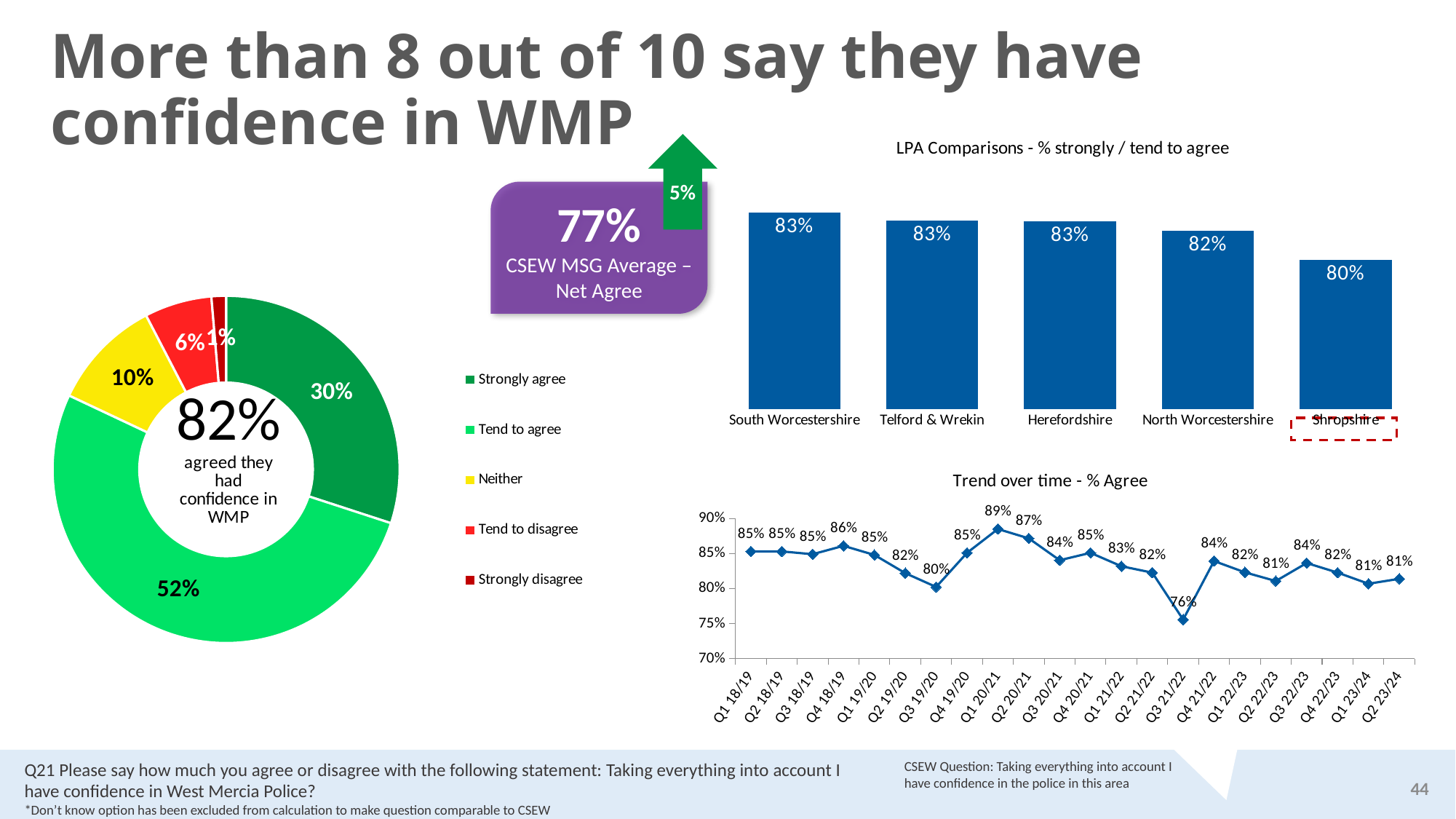
In the 'LPA Comparisons - % strongly / tend to agree' chart, which LPA has the lowest value? Shropshire In the donut chart on the left, what percentage of respondents said they 'Tend to agree'? 52% In the donut chart on the left, what is the difference between the 'Neither' share and the 'Tend to disagree' share? 4% In the 'LPA Comparisons - % strongly / tend to agree' chart, what is the value for Shropshire? 80% In the 'Trend over time - % Agree' chart, what is the value for Q3 21/22? 76% In the 'Trend over time - % Agree' chart, which quarter has the highest value? Q1 20/21 What kind of chart is the 'LPA Comparisons - % strongly / tend to agree' chart? Bar chart In the donut chart on the left, which response category has the smallest share? Strongly disagree How many LPAs are shown in the 'LPA Comparisons - % strongly / tend to agree' chart? 5 In the donut chart on the left, what percentage of respondents said they 'Strongly agree'? 30% How many series does the legend of the donut chart on the left list? 5 In the 'Trend over time - % Agree' chart, what is the difference between the Q1 20/21 value and the Q2 23/24 value? 8%